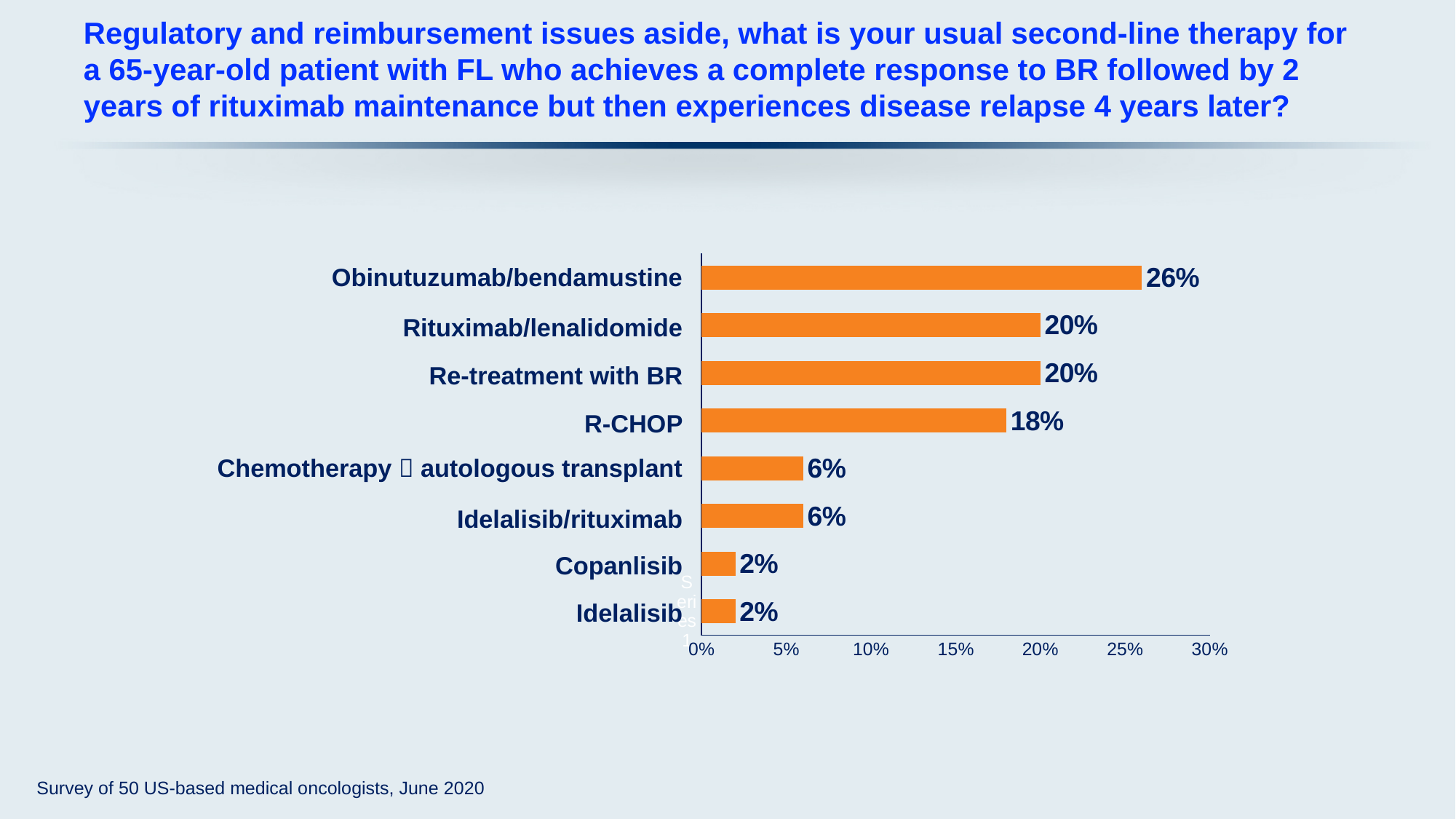
How many therapy options are shown in the chart? 8 What percentage of respondents chose Obinutuzumab/bendamustine as their usual second-line therapy? 26% What is the difference between the values for Rituximab/lenalidomide and Idelalisib/rituximab? 14% Which has a larger value, R-CHOP or Re-treatment with BR? Re-treatment with BR What is the difference between the values for Obinutuzumab/bendamustine and R-CHOP? 8% What is the value for Copanlisib? 2% What is the maximum value shown on the x axis of the chart? 30% What is the value shown for R-CHOP? 18% Is the value for Obinutuzumab/bendamustine greater or less than 25%? greater What percentage is shown for Idelalisib/rituximab? 6% Which therapy has the highest percentage in the chart? Obinutuzumab/bendamustine What type of chart is shown on the slide? Bar chart